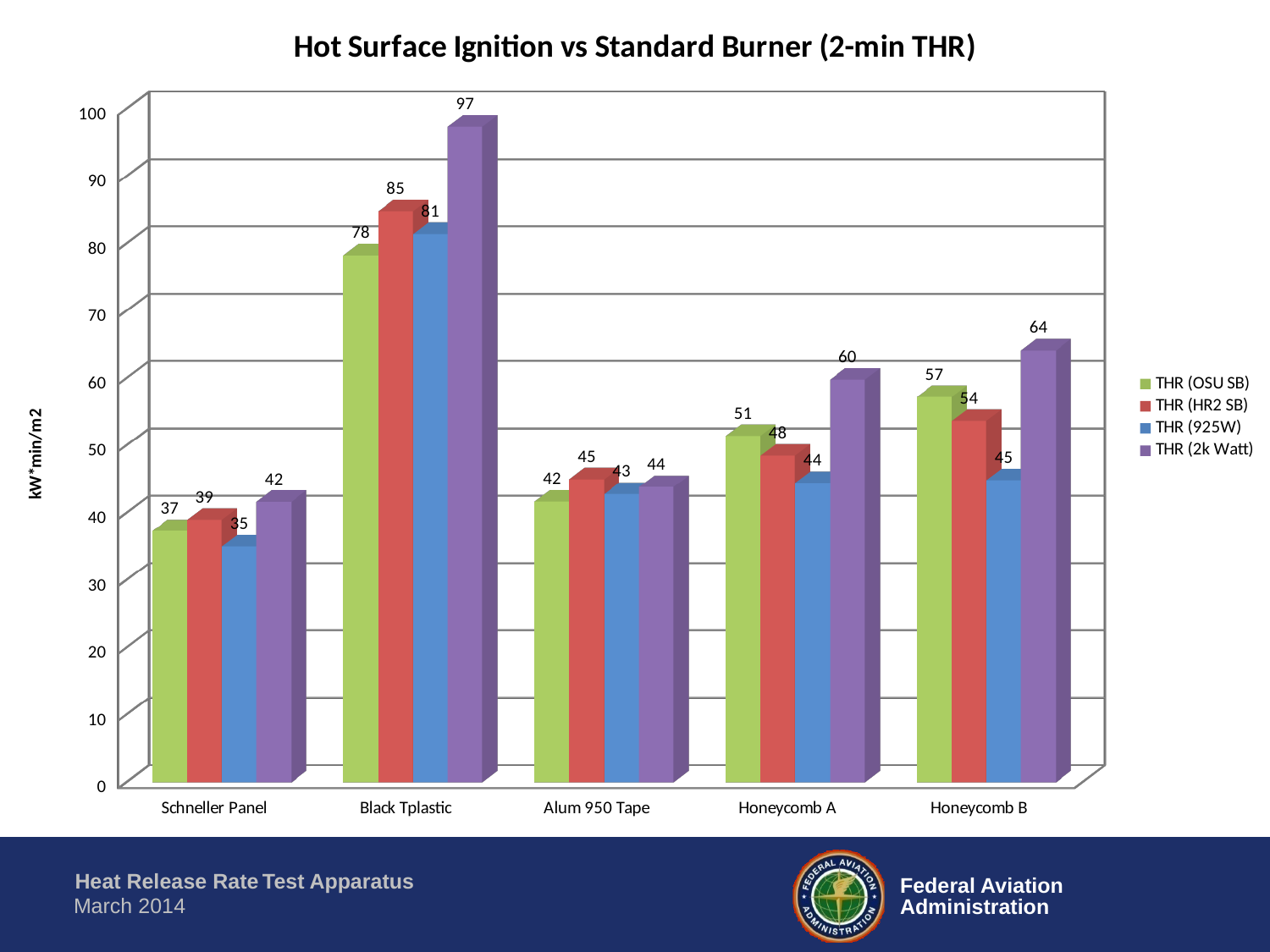
What is the THR (2k Watt) value for Black Tplastic? 97 What kind of chart is shown on the slide? Bar chart How many categories are shown on the x axis? 5 What is the THR (OSU SB) value for Honeycomb B? 57 What is the difference between the THR (2k Watt) and THR (OSU SB) values for Honeycomb A? 9 Which category has the highest THR (HR2 SB) value? Black Tplastic What is the label on the y axis? kW*min/m2 Which is larger for Honeycomb B: THR (HR2 SB) or THR (925W)? THR (HR2 SB) Which category has the lowest THR (OSU SB) value? Schneller Panel What is the title of the chart? Hot Surface Ignition vs Standard Burner (2-min THR) How many series does the legend list? 4 What is the THR (925W) value for Schneller Panel? 35